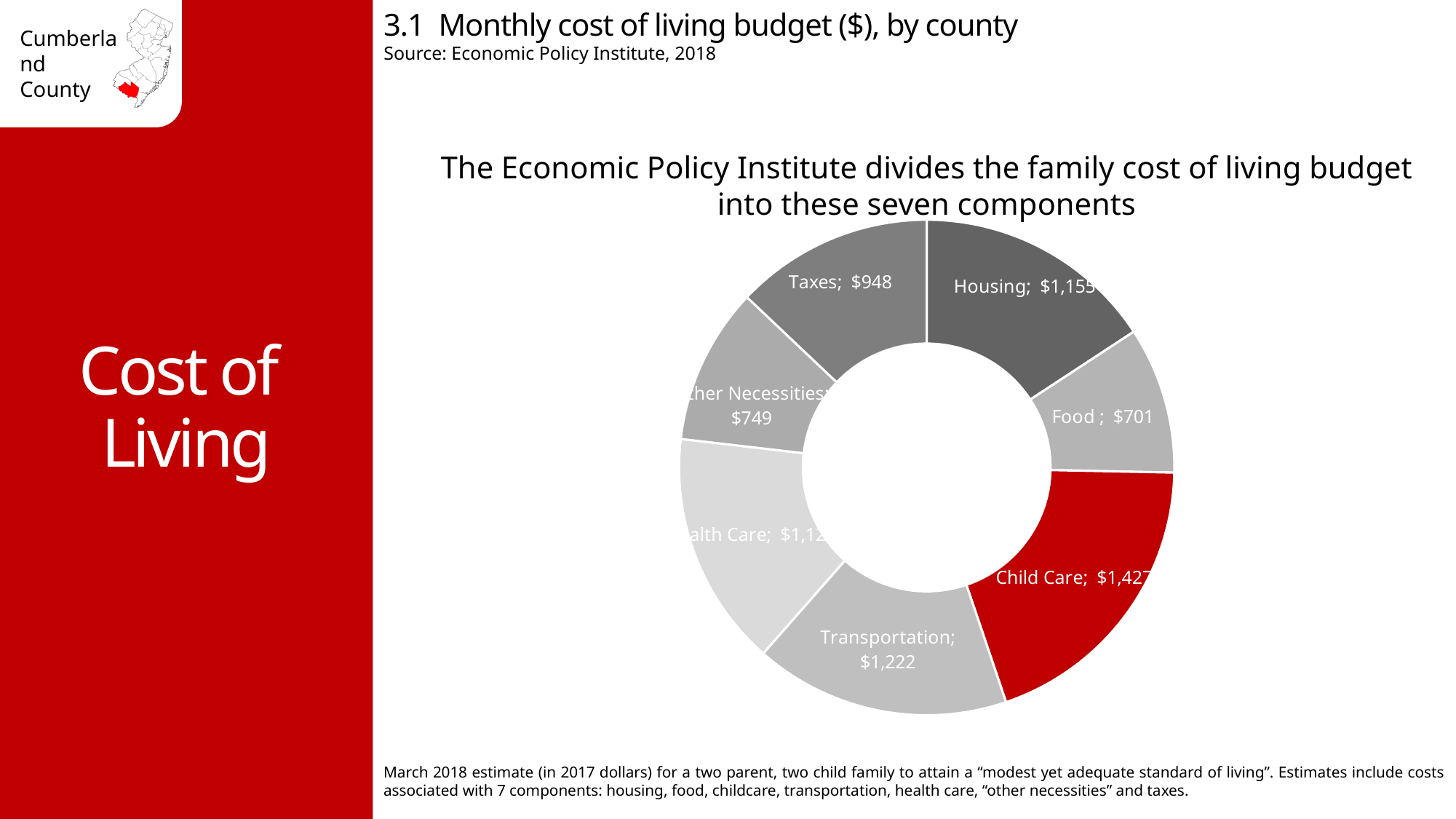
How much more is the monthly cost of Child Care than Housing? $272 Which component has the lowest monthly cost? Food What is the monthly cost for Other Necessities? $749 How many components (slices) does the chart show? 7 What is the monthly cost for Transportation? $1,222 Which component has the highest monthly cost? Child Care Which slice of the chart is coloured red? Child Care What is the monthly cost for Housing? $1,155 What is the monthly cost for Food? $701 What is the monthly cost for Taxes? $948 What kind of chart is shown on the slide? doughnut chart What is the monthly cost for Child Care? $1,427